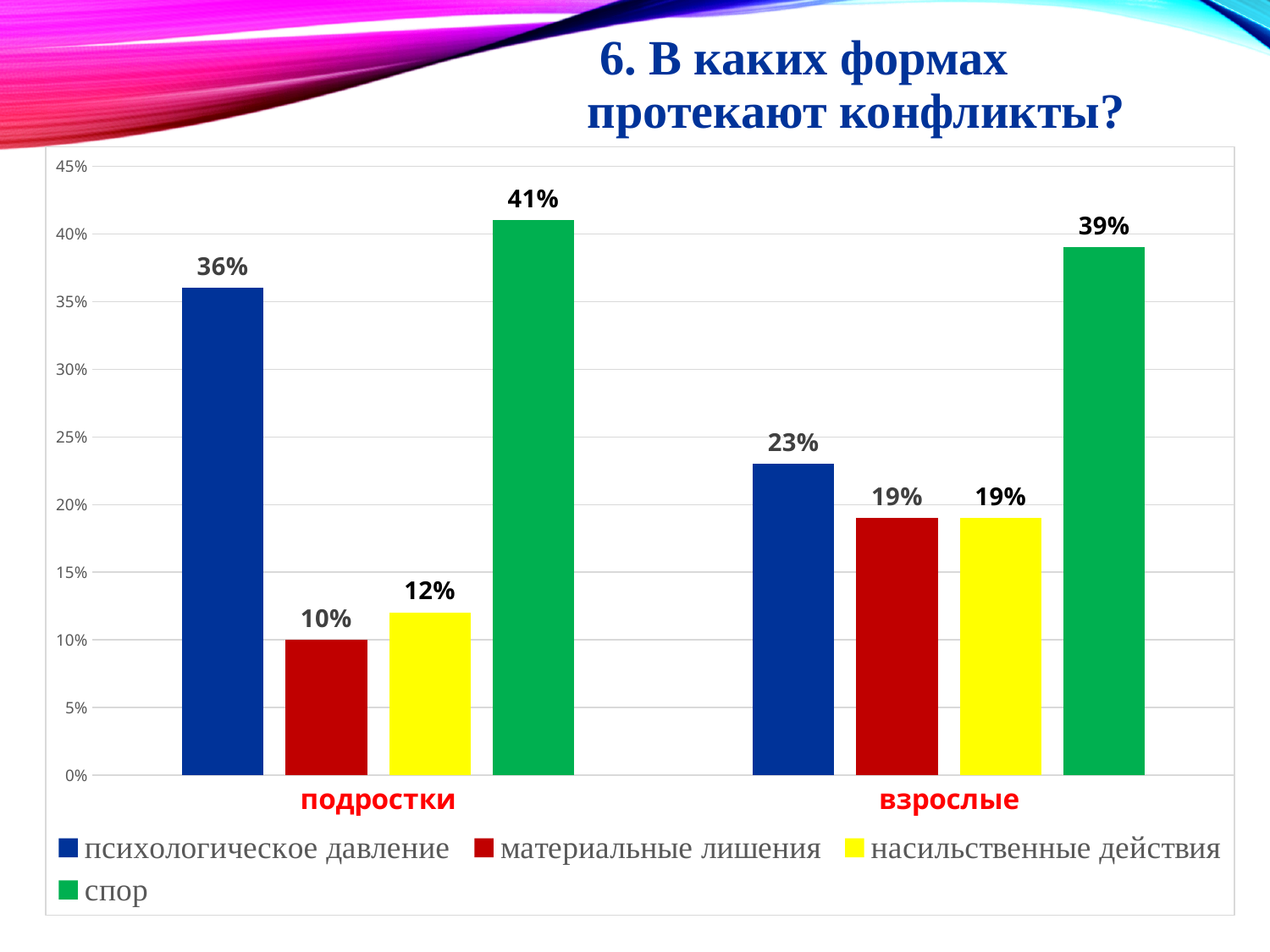
What is the value for "психологическое давление" in the "подростки" category? 36% How many series does the legend list? 4 What is the value for "материальные лишения" in the "взрослые" category? 19% Which series has the highest value in the "взрослые" category? спор What is the value for "спор" in the "подростки" category? 41% How many categories are shown on the x axis? 2 What is the difference between the "психологическое давление" values for "подростки" and "взрослые"? 13% What is the difference between "спор" and "психологическое давление" in the "подростки" category? 5% Which series has the lowest value in the "подростки" category? материальные лишения Which is larger: "насильственные действия" for "подростки" or for "взрослые"? взрослые What kind of chart is shown on the slide? bar chart What colour are the bars for the "спор" series? green